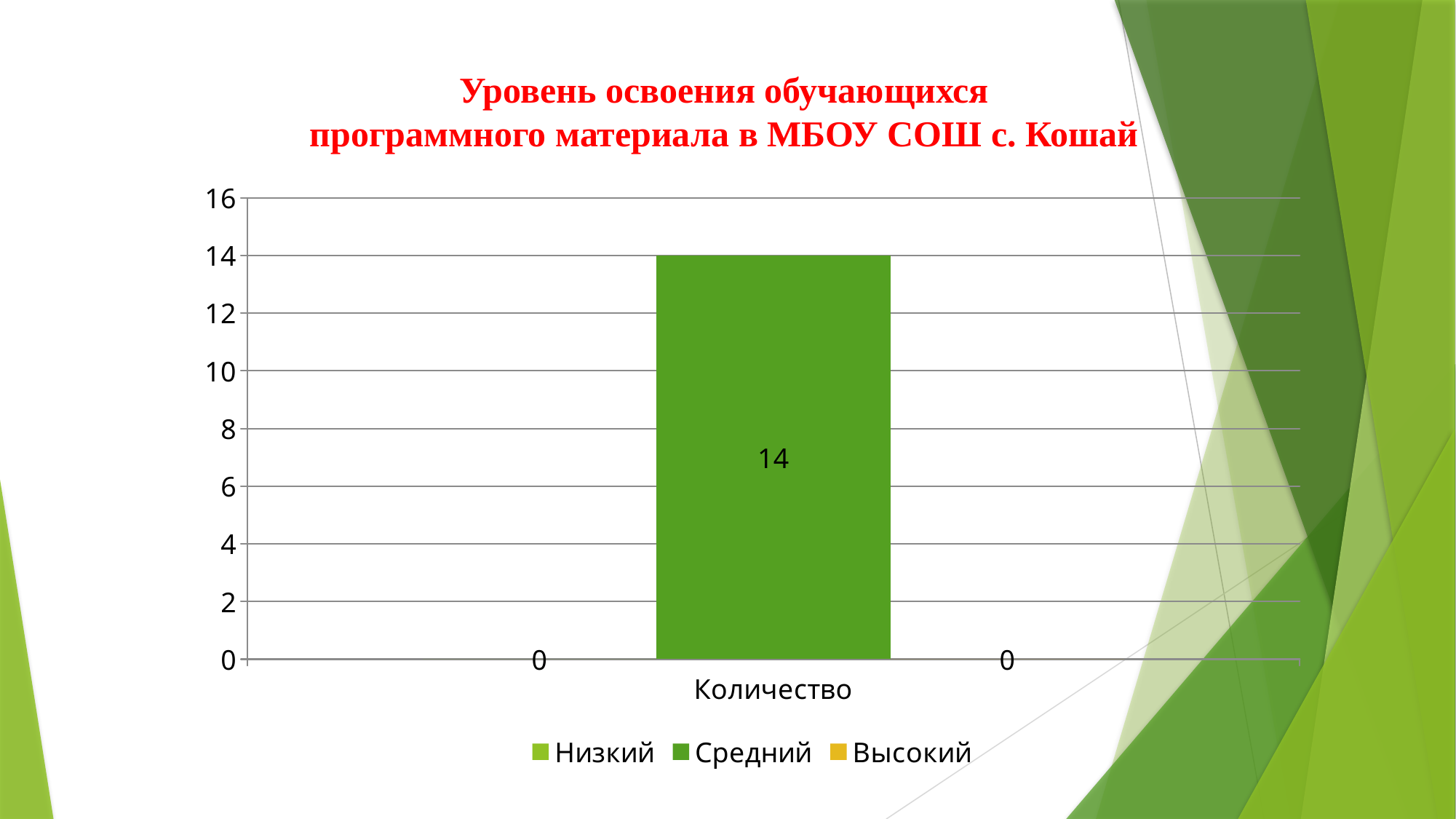
How many series does the legend list? 3 What is the highest value shown on the y axis? 16 What is the difference between the Средний value and the Низкий value? 14 Which is larger, the value for Средний or the value for Высокий? Средний What type of chart is shown on the slide? bar chart Is the value for Средний greater or less than 10? greater How many categories are shown on the x axis? 1 What is the label of the category on the x axis? Количество Which series has the highest value in the Количество category? Средний What is the value for the Низкий series in the Количество category? 0 What is the value for the Средний series in the Количество category? 14 What is the value for the Высокий series in the Количество category? 0